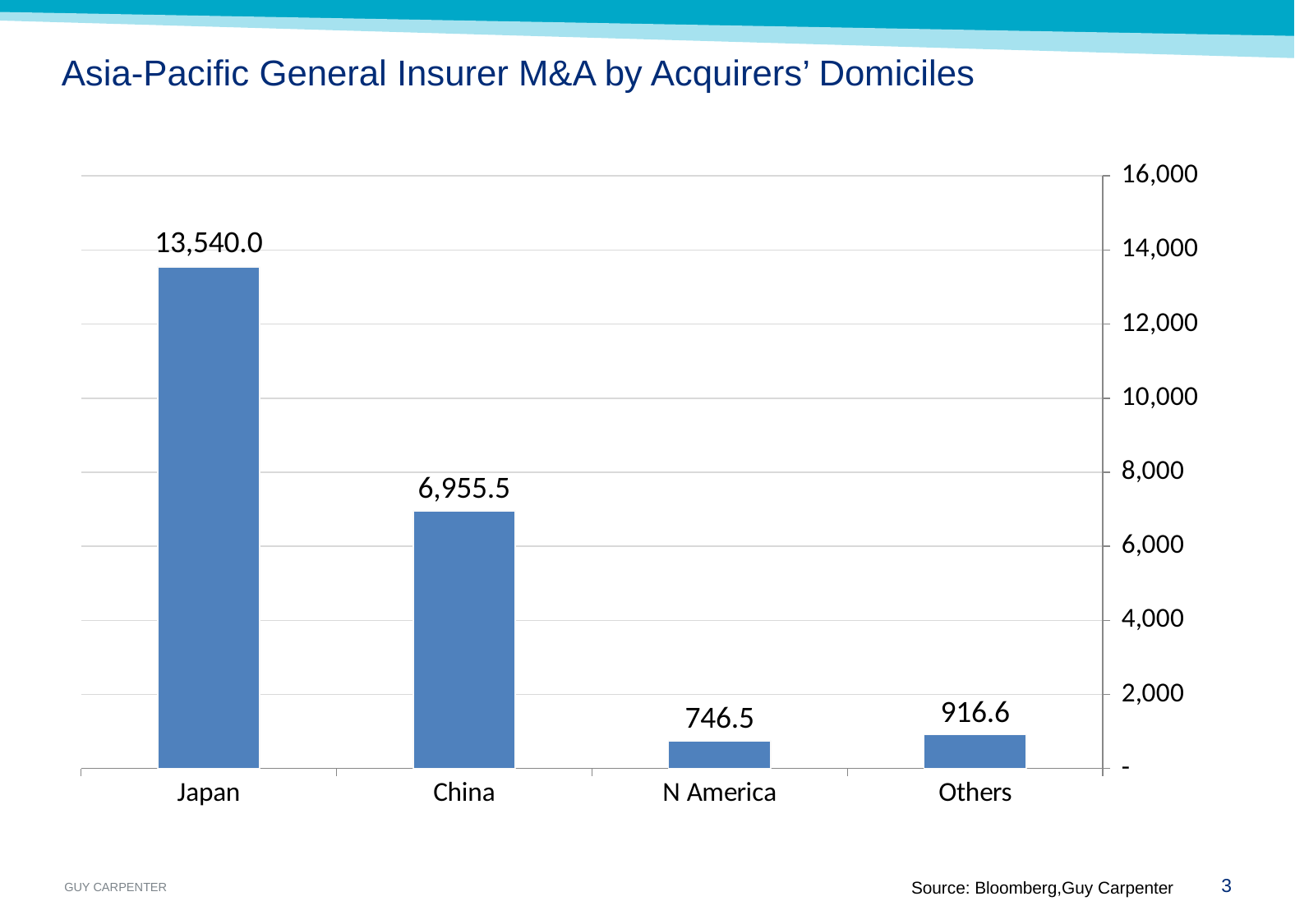
Which is larger, the value for China or the value for Others? China What is the value for China? 6,955.5 Which category has the lowest value? N America What is the value for Others? 916.6 What is the difference between the values for Japan and China? 6,584.5 How many categories are shown on the x axis? 4 What is the title of the slide? Asia-Pacific General Insurer M&A by Acquirers' Domiciles What kind of chart is shown on the slide? Bar chart What is the value for N America? 746.5 What is the difference between the values for Others and N America? 170.1 Which category has the highest value? Japan What is the value for Japan? 13,540.0